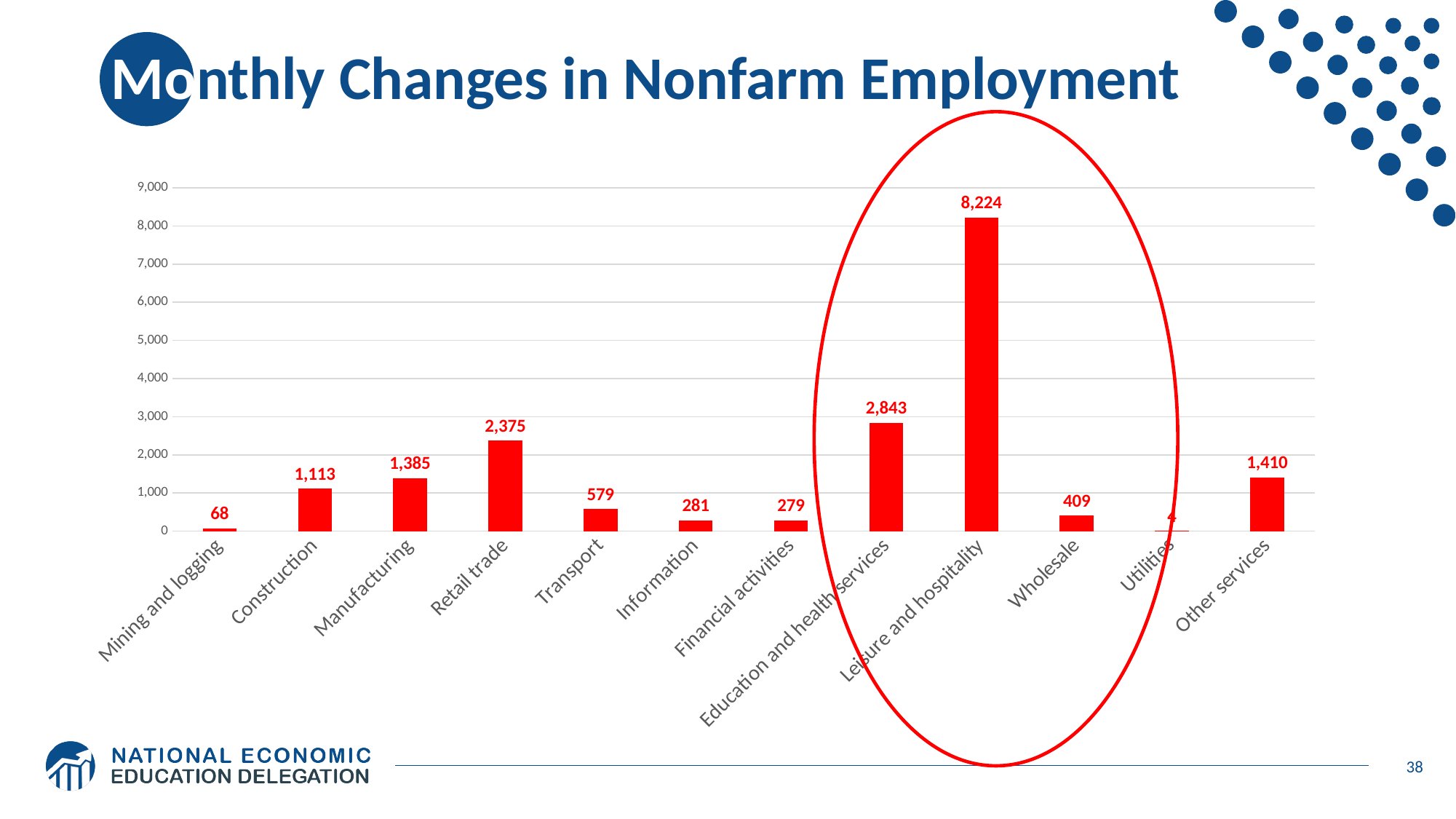
Which category has the highest value? Leisure and hospitality Which category has the lowest value? Utilities How many categories are shown on the x axis? 12 What is the value for Mining and logging? 68 What is the value for Leisure and hospitality? 8,224 What is the difference between the values for Leisure and hospitality and Education and health services? 5,381 What kind of chart is shown on the slide? Bar chart Is the value for Education and health services greater or less than 2,000? greater What is the value for Retail trade? 2,375 What is the value for Other services? 1,410 Which is larger, the value for Manufacturing or the value for Construction? Manufacturing What is the title of the slide? Monthly Changes in Nonfarm Employment